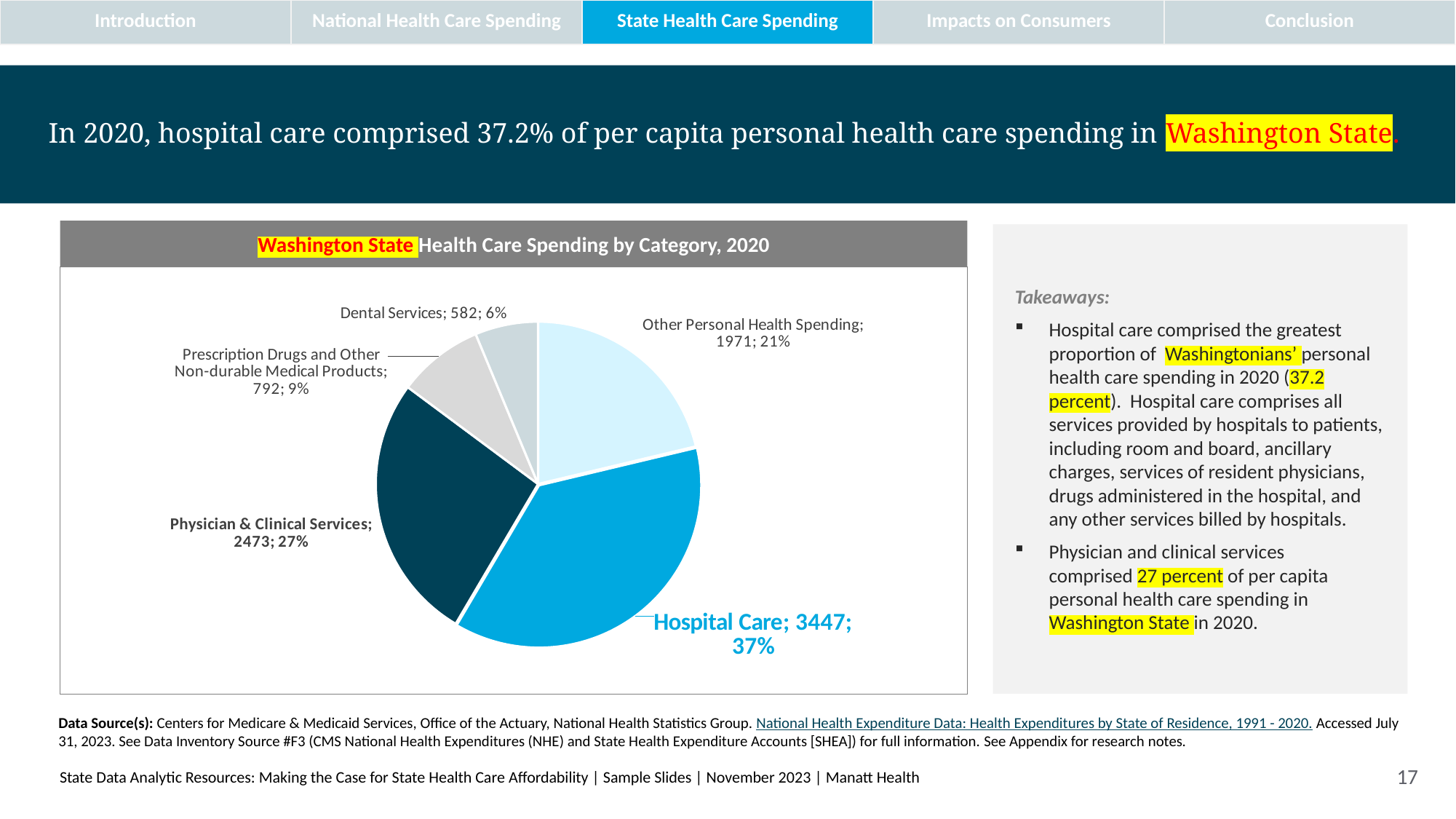
Which is larger, the value for Prescription Drugs and Other Non-durable Medical Products or the value for Dental Services? Prescription Drugs and Other Non-durable Medical Products How many categories does the pie chart show? 5 What is the value for Physician & Clinical Services? 2473 What is the value for Hospital Care? 3447 What is the title of the chart? Washington State Health Care Spending by Category, 2020 Which category has the largest slice of the pie? Hospital Care What is the value for Dental Services? 582 What is the value for Prescription Drugs and Other Non-durable Medical Products? 792 What is the difference between the values for Hospital Care and Physician & Clinical Services? 974 What share of the pie does Other Personal Health Spending represent? 21% What kind of chart is shown on the slide? Pie chart Which category has the smallest slice of the pie? Dental Services